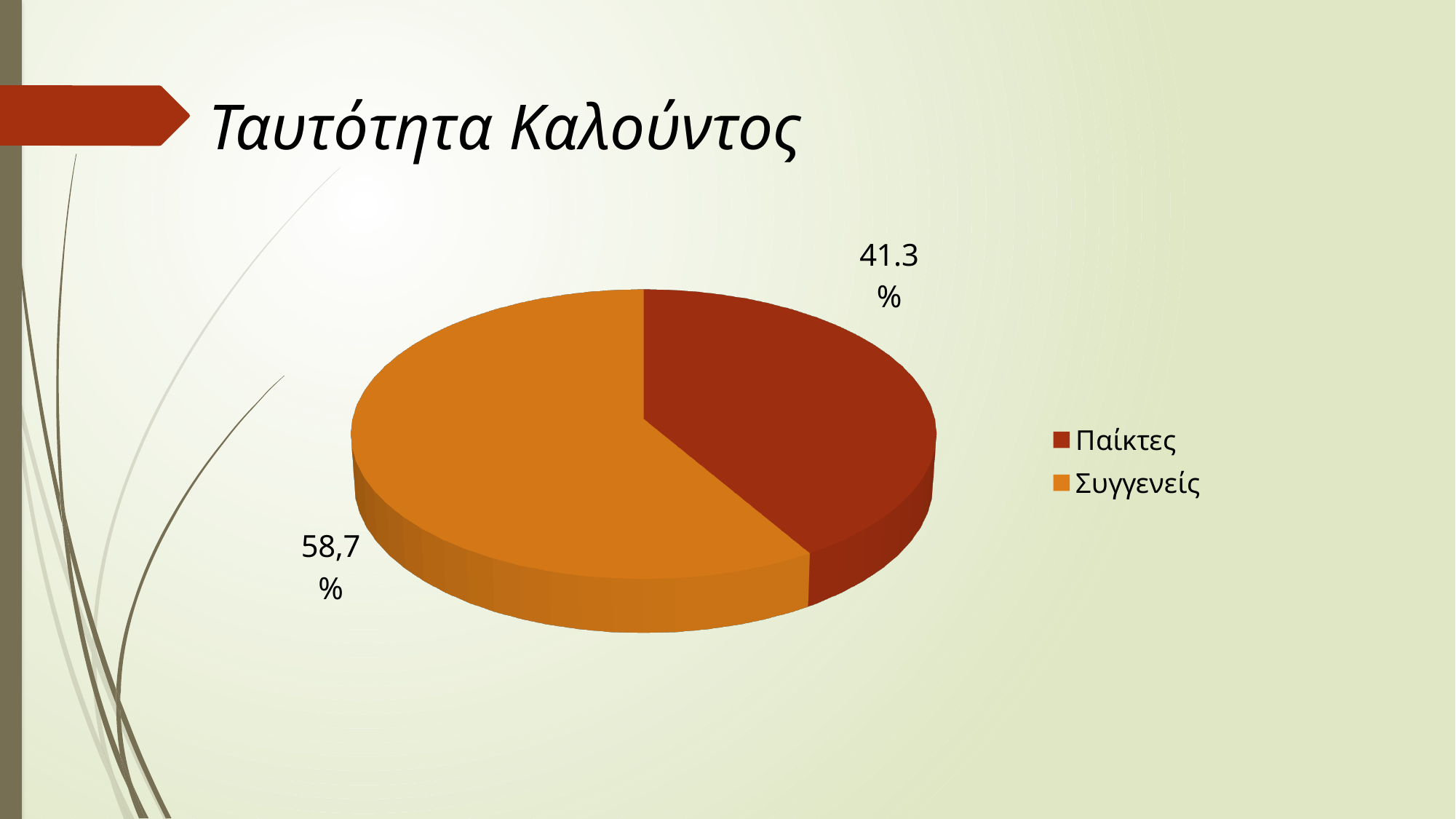
Which is larger, the slice for Παίκτες or the slice for Συγγενείς? Συγγενείς What colour is the Παίκτες slice? dark red By how many percentage points is the Συγγενείς slice larger than the Παίκτες slice? 17.4 What share of the pie does Παίκτες have? 41.3% What share of the pie does Συγγενείς have? 58,7% Which category has the smallest slice of the pie? Παίκτες What kind of chart is shown on the slide? pie chart How many entries does the legend list? 2 What is the title of the slide containing the pie chart? Ταυτότητα Καλούντος How many slices does the pie chart have? 2 Which category has the largest slice of the pie? Συγγενείς